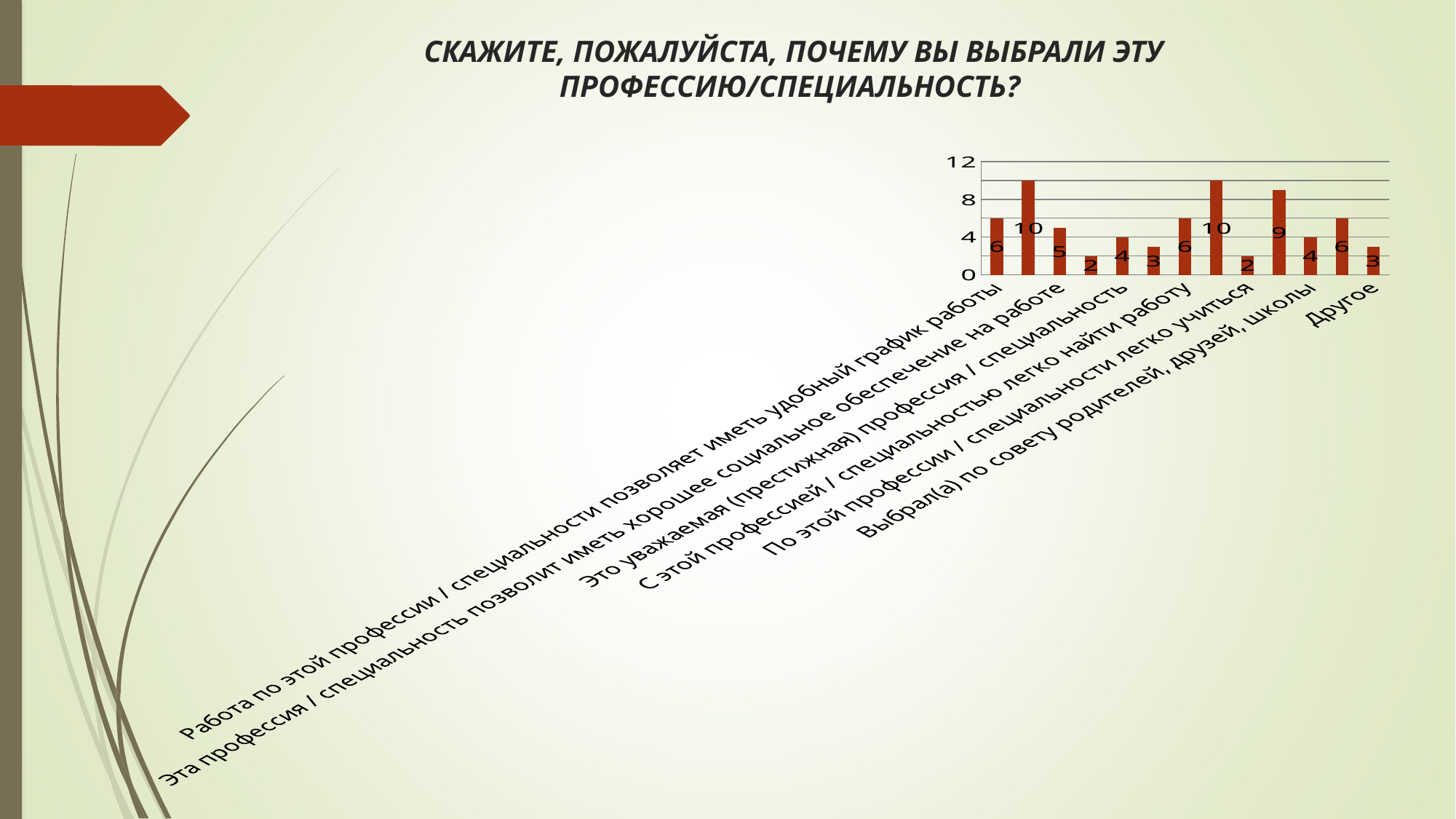
What is the value for "Выбрал(а) по совету родителей, друзей, школы"? 4 Which is larger: the value for "Работа по этой профессии / специальности позволяет иметь удобный график работы" or the value for "Другое"? Работа по этой профессии / специальности позволяет иметь удобный график работы What is the value for "С этой профессией / специальностью легко найти работу"? 6 What is the value for "По этой профессии / специальности легко учиться"? 2 What is the value for "Другое"? 3 What is the difference between the value for "С этой профессией / специальностью легко найти работу" and the value for "По этой профессии / специальности легко учиться"? 4 What is the value for "Работа по этой профессии / специальности позволяет иметь удобный график работы"? 6 What is the value for "Это уважаемая (престижная) профессия / специальность"? 4 What is the value for "Эта профессия / специальность позволит иметь хорошее социальное обеспечение на работе"? 5 What kind of chart is shown on the slide? bar chart Is the value for "Другое" greater or less than 4? less How many bars are plotted in the chart? 13